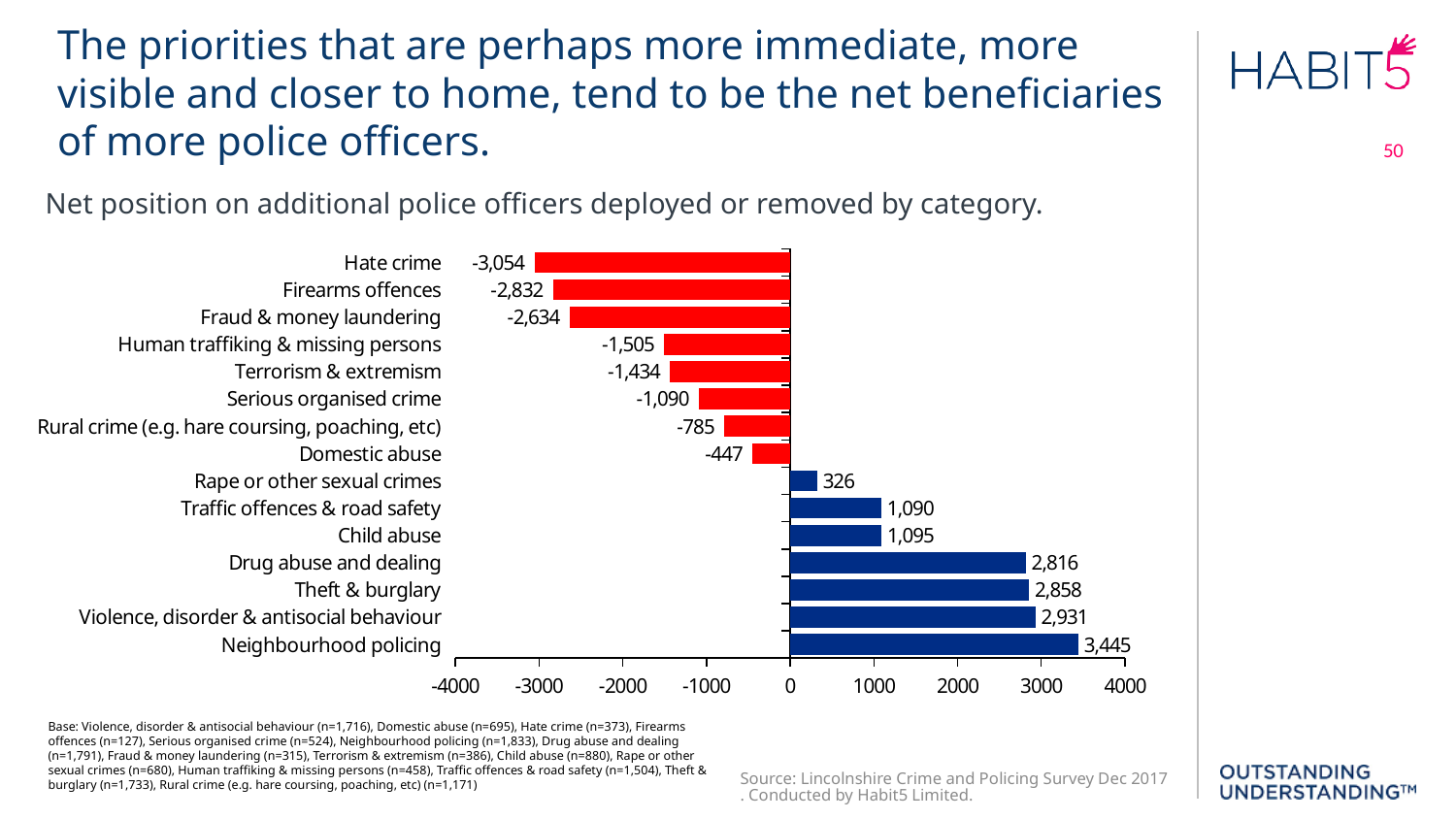
What is the difference between the values for Neighbourhood policing and Violence, disorder & antisocial behaviour? 514 Which category has the highest net position value? Neighbourhood policing What colour are the bars with negative values? Red What is the net position value for Domestic abuse? -447 What is the net position value for Neighbourhood policing? 3,445 What is the difference between the values for Firearms offences and Fraud & money laundering? 198 Which category has the lowest net position value? Hate crime How many categories are shown in the chart? 15 What kind of chart is shown on the slide? Bar chart What is the net position value for Rape or other sexual crimes? 326 Which has a larger net position value, Drug abuse and dealing or Theft & burglary? Theft & burglary What is the net position value for Hate crime? -3,054